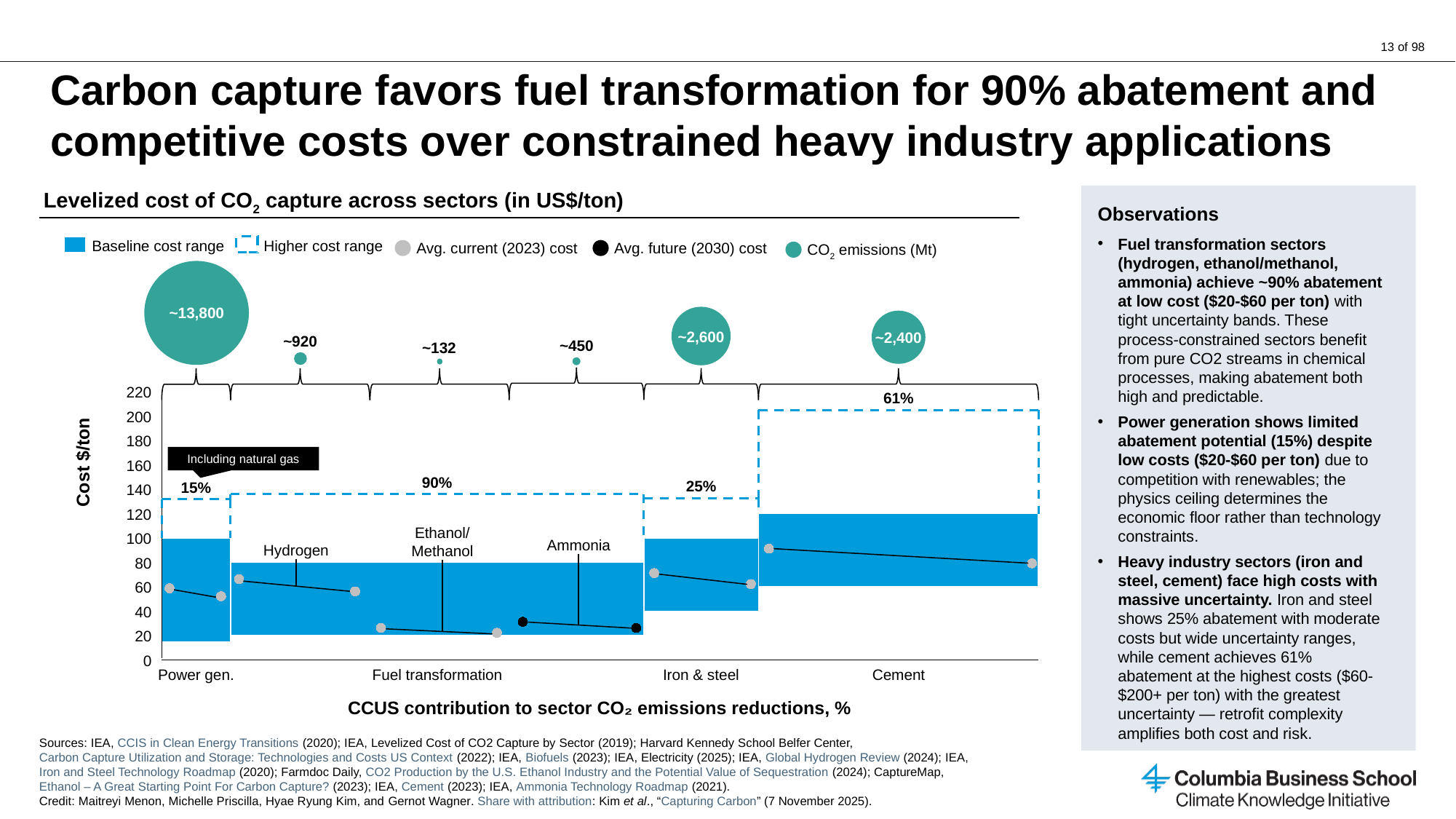
Which sub-sector has the smallest CO2 emissions bubble? Ethanol/Methanol (~132) What is the difference between the CCUS contribution percentages for Cement and Iron & steel? 36 percentage points What CO2 emissions value (Mt) is shown in the bubble above Power gen.? ~13,800 Is the top of the higher cost range for Cement greater or less than 200 $/ton? greater How many sectors are labelled along the x axis of the chart? 4 Which has the larger CO2 emissions bubble, Iron & steel or Cement? Iron & steel What CCUS contribution percentage is shown for Cement? 61% What kind of chart is shown under 'Levelized cost of CO2 capture across sectors'? bar chart What CO2 emissions value (Mt) is shown for Iron & steel? ~2,600 How many entries does the chart's legend list? 5 Which sector has the largest CO2 emissions bubble? Power gen. Which sector shows the lowest CCUS contribution percentage? Power gen. (15%)